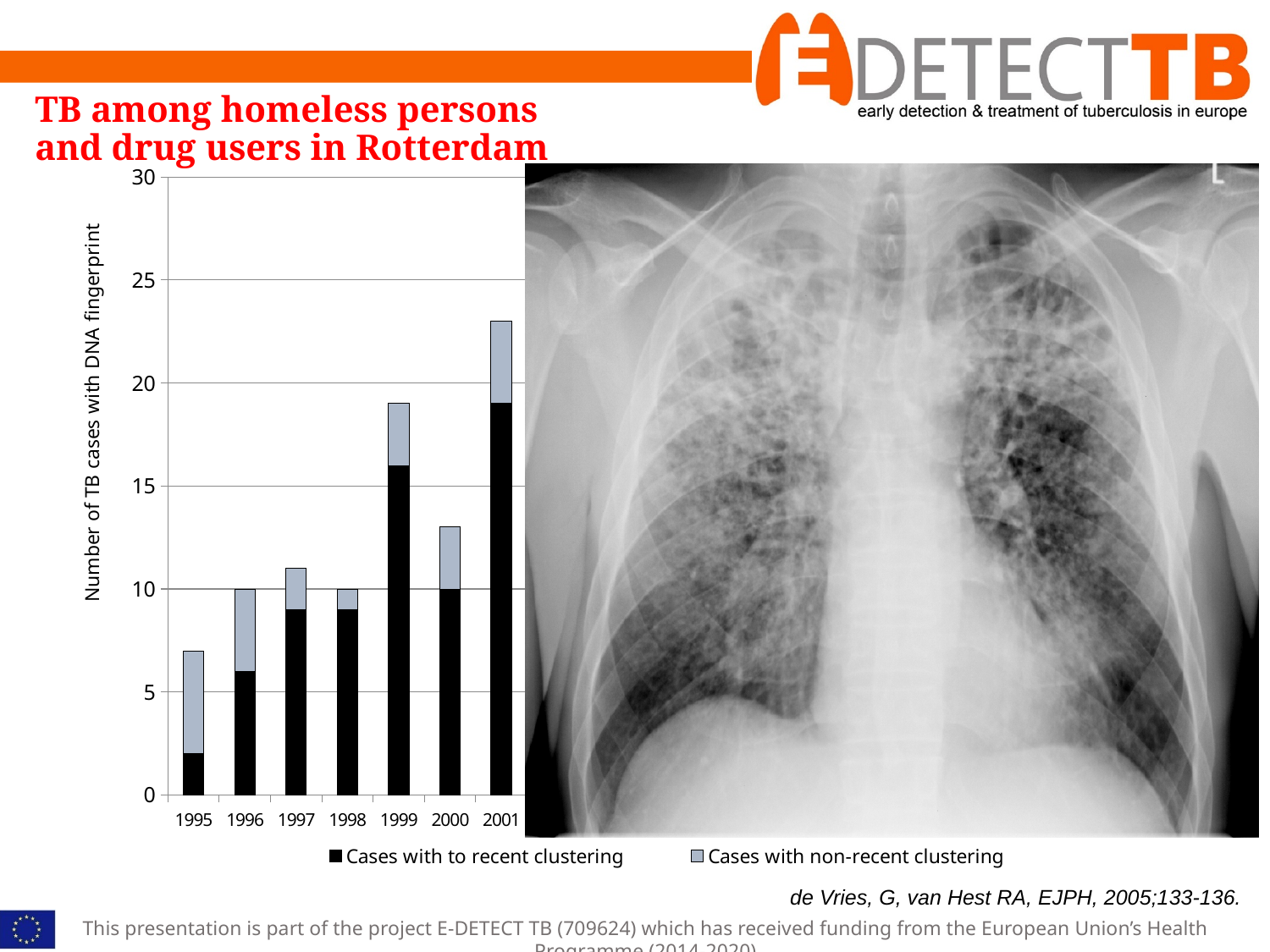
What is the total number of TB cases with DNA fingerprint for 1996? 10 What kind of chart is shown on the slide? bar chart Which year has a larger total number of cases, 1999 or 2000? 1999 Which year has the lowest total number of TB cases in the chart? 1995 Is the number of cases with recent clustering in 1999 greater or less than 15? greater How many years are shown on the x axis of the chart? 7 What is the label on the y axis of the chart? Number of TB cases with DNA fingerprint Is the total number of cases for 2001 greater or less than 20? greater Which year has the highest total number of TB cases in the chart? 2001 How many cases with recent clustering were there in 2000? 10 What is the total number of TB cases with DNA fingerprint for 1998? 10 How many series does the chart legend list? 2